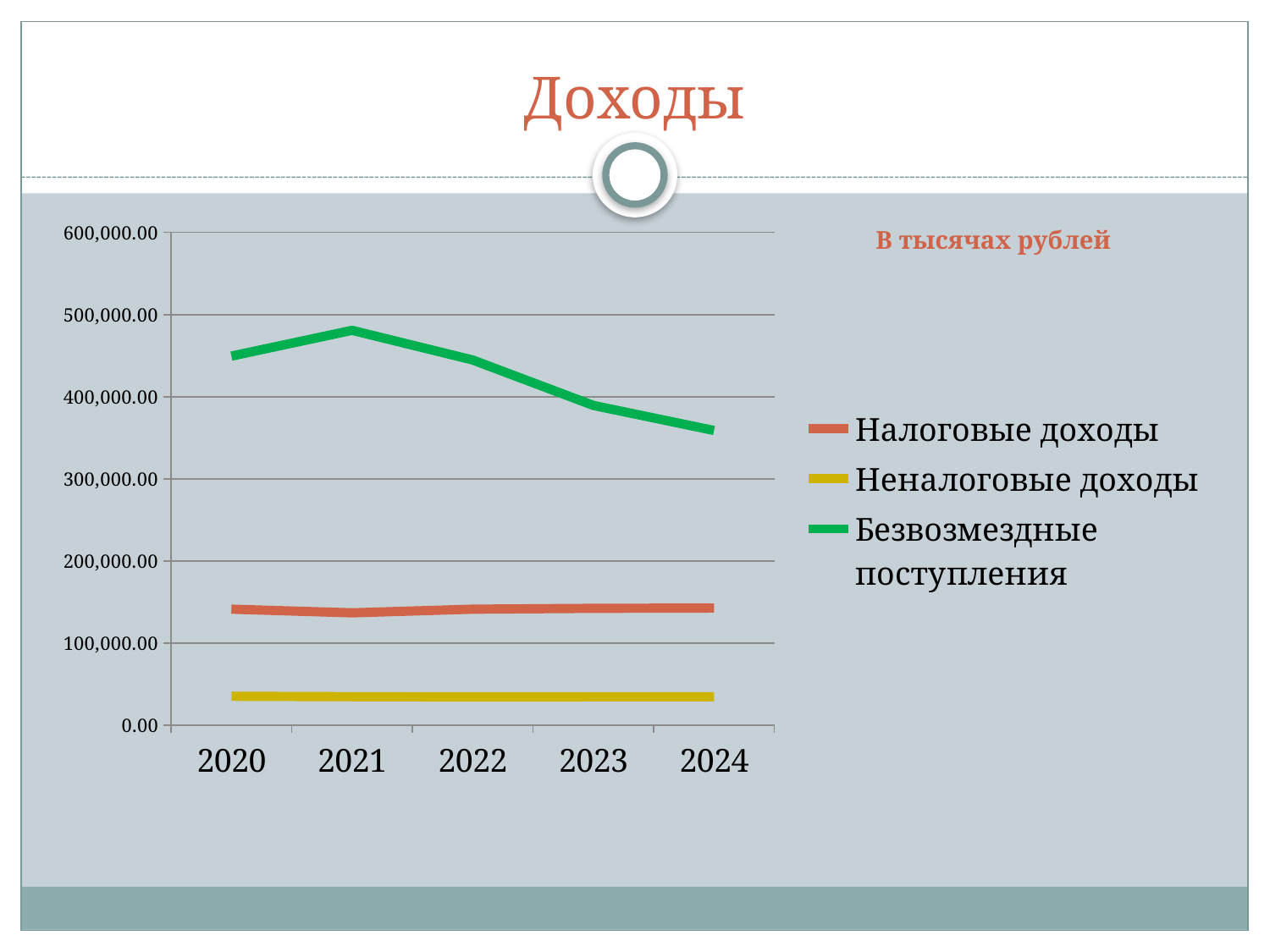
Is the value for Неналоговые доходы in 2022 greater or less than 100,000.00? less Which series has the highest values across all years? Безвозмездные поступления Is the value for Безвозмездные поступления in 2021 greater or less than 400,000.00? greater Which is larger for Безвозмездные поступления: the value in 2020 or in 2024? 2020 What kind of chart is shown on the slide? Line chart How many series does the legend list? 3 Do the values for Безвозмездные поступления rise or fall from 2021 to 2024? fall Which series has the lowest values across all years? Неналоговые доходы How many years are shown on the x axis? 5 In which year does Безвозмездные поступления reach its highest value? 2021 Is the value for Безвозмездные поступления in 2024 greater or less than 400,000.00? less